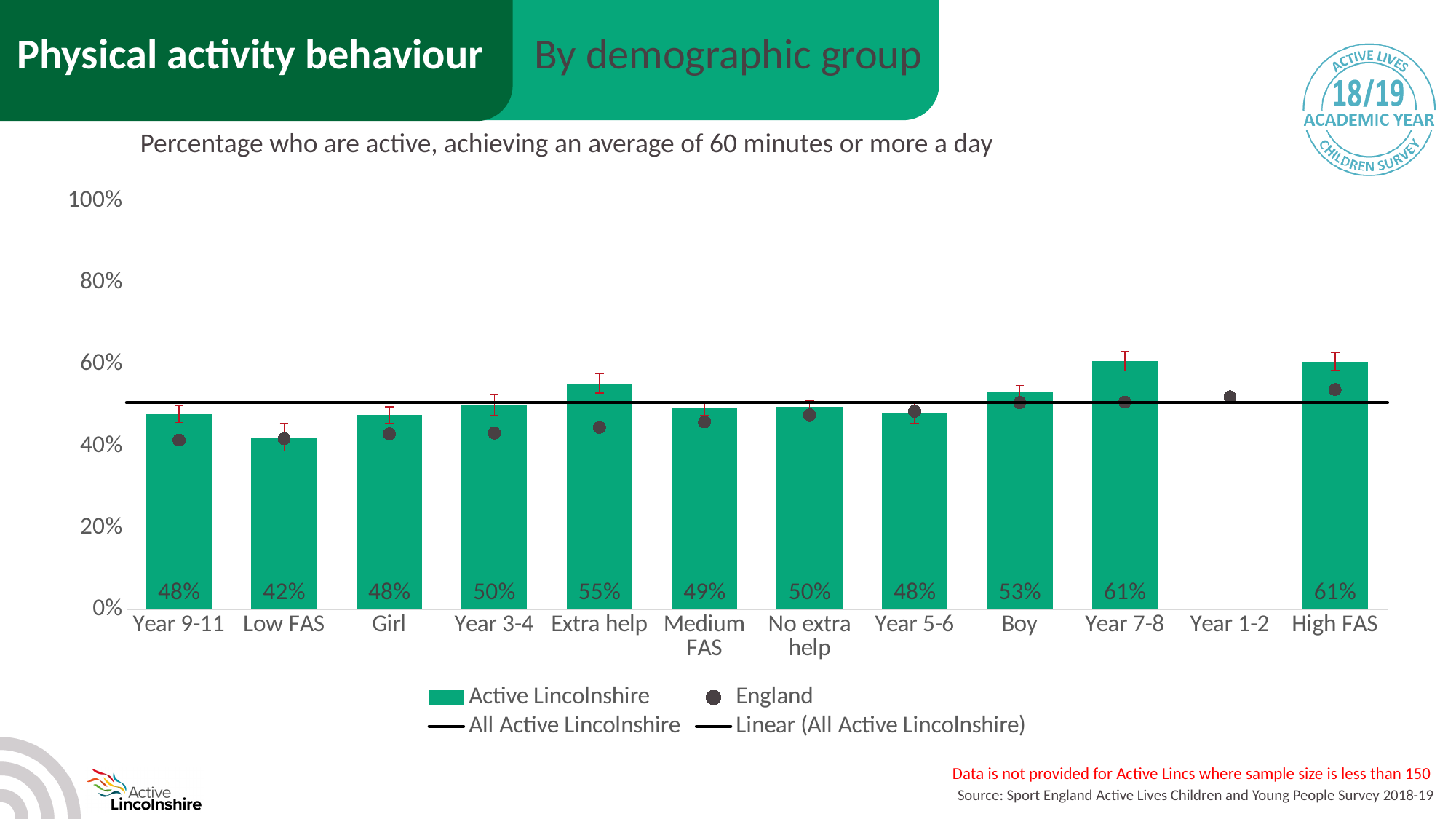
What is the Active Lincolnshire value for Extra help? 55% How many entries does the legend list? 4 How many demographic groups are shown on the x axis? 12 Which has the larger Active Lincolnshire value, Boy or Girl? Boy What is the Active Lincolnshire value for Year 7-8? 61% What kind of chart is shown on the slide? Bar chart Which demographic group has no Active Lincolnshire bar shown? Year 1-2 What is the Active Lincolnshire value for Boy? 53% What is the difference between the Active Lincolnshire values for Extra help and Low FAS? 13 percentage points What is the Active Lincolnshire value for Low FAS? 42% Is the England value for Extra help greater or less than 40%? greater Which demographic group has the lowest Active Lincolnshire value? Low FAS